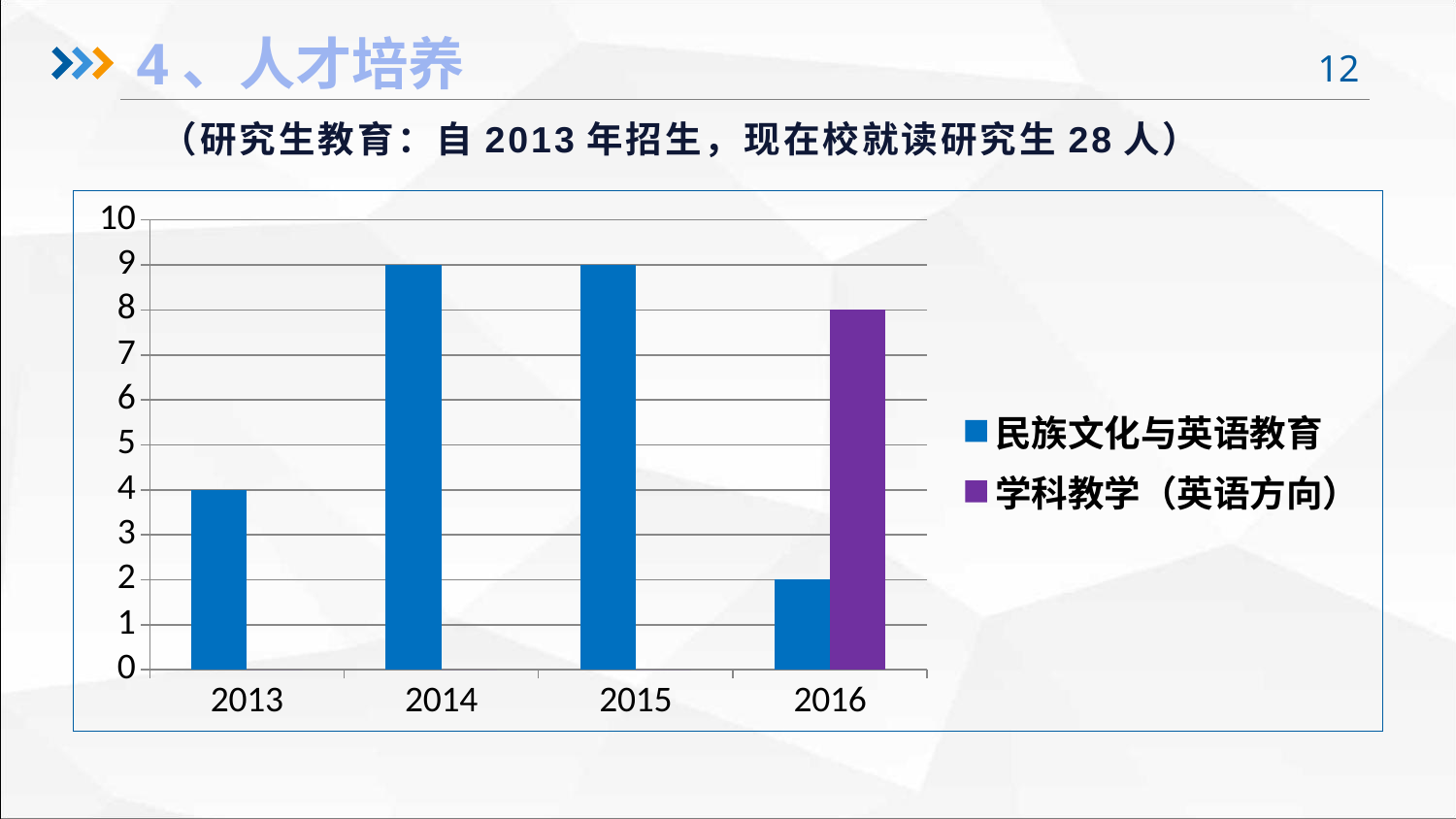
What is the value for 民族文化与英语教育 in 2016? 2 How many series does the legend list? 2 What type of chart is shown on the slide? bar chart What is the value for 民族文化与英语教育 in 2013? 4 Is the value for 民族文化与英语教育 in 2015 greater or less than 5? greater In which year is the value for 民族文化与英语教育 the lowest? 2016 What is the difference between the 2014 and 2013 values for 民族文化与英语教育? 5 In 2016, which series has the larger value, 民族文化与英语教育 or 学科教学（英语方向）? 学科教学（英语方向） How many years are shown on the x axis? 4 What is the value for 民族文化与英语教育 in 2014? 9 What is the value for 学科教学（英语方向） in 2016? 8 Which colour represents 学科教学（英语方向） in the legend? purple